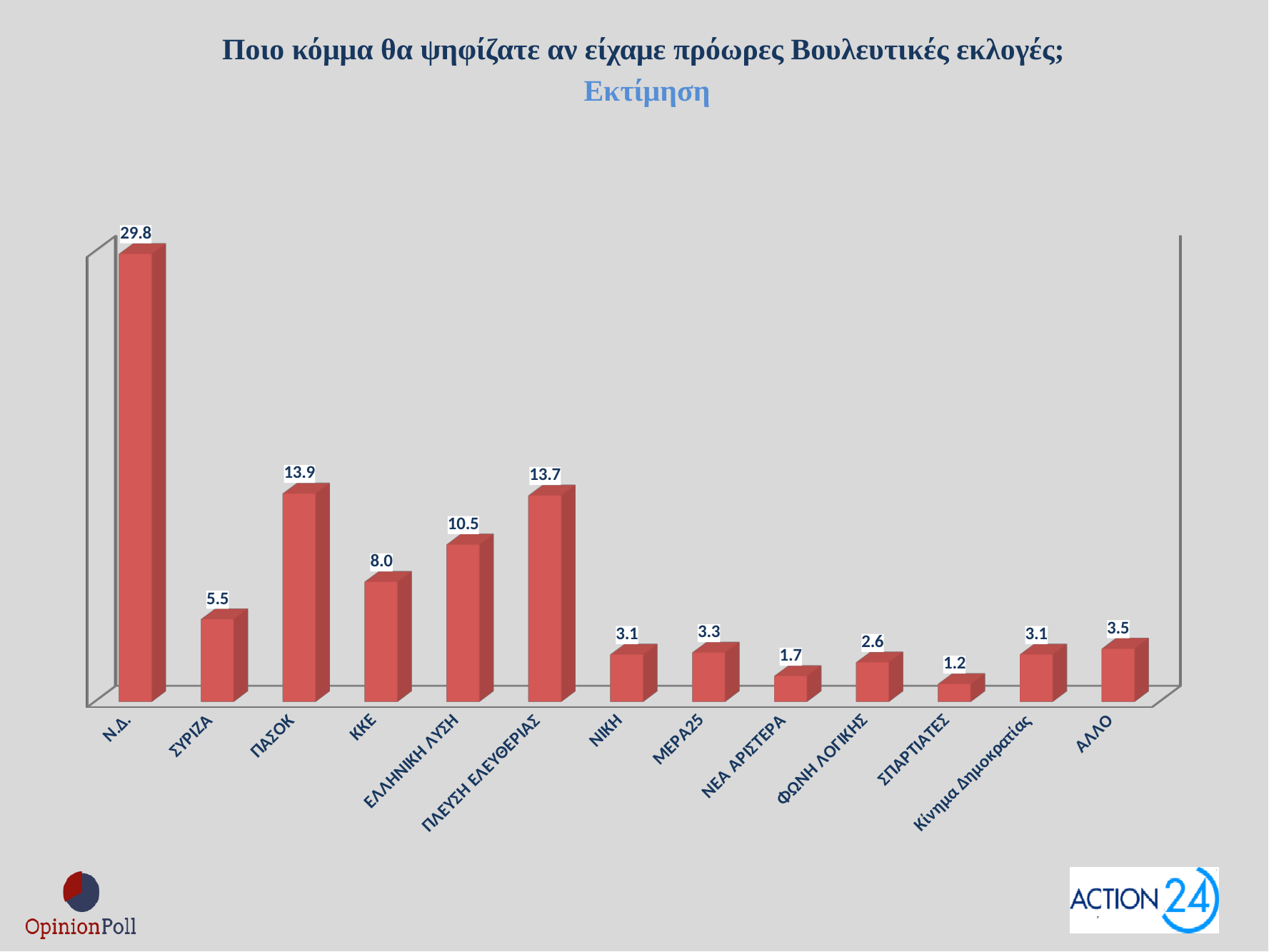
What is the value for ΚΚΕ? 8.0 How many categories are shown in the chart? 13 What is the difference between the values for Ν.Δ. and ΠΑΣΟΚ? 15.9 What is the value for ΠΛΕΥΣΗ ΕΛΕΥΘΕΡΙΑΣ? 13.7 What is the value for Ν.Δ.? 29.8 Which is larger, the value for ΠΑΣΟΚ or the value for ΠΛΕΥΣΗ ΕΛΕΥΘΕΡΙΑΣ? ΠΑΣΟΚ What is the difference between the values for ΕΛΛΗΝΙΚΗ ΛΥΣΗ and ΣΥΡΙΖΑ? 5.0 What kind of chart is shown on the slide? Bar chart What is the subtitle shown below the chart's main title? Εκτίμηση Which category has the highest value? Ν.Δ. Which category has the lowest value? ΣΠΑΡΤΙΑΤΕΣ What is the value for ΣΠΑΡΤΙΑΤΕΣ? 1.2